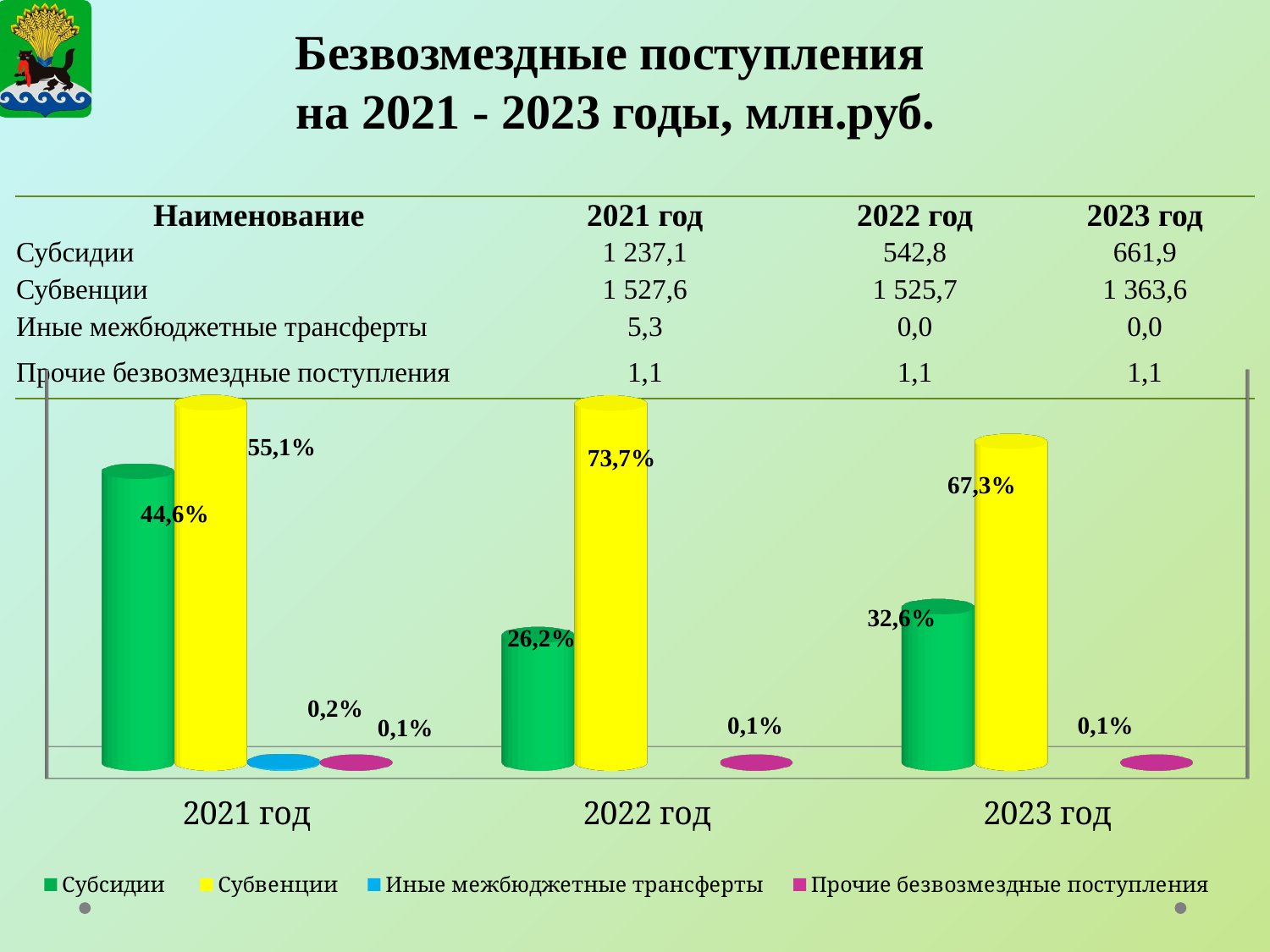
In which year does Субвенции have its highest share on the chart? 2022 год What type of chart is shown on the slide? Bar chart What is the data label for Прочие безвозмездные поступления in 2023 год on the chart? 0,1% What is the data label for Субсидии in 2021 год on the chart? 44,6% How many year categories are shown on the x axis of the chart? 3 What is the data label for Иные межбюджетные трансферты in 2021 год on the chart? 0,2% Which is larger in 2021 год on the chart: Субсидии or Субвенции? Субвенции What is the data label for Субвенции in 2022 год on the chart? 73,7% What is the data label for Субсидии in 2023 год on the chart? 32,6% In which year does Субсидии have its lowest share on the chart? 2022 год How many series does the chart legend list? 4 What is the difference between the Субвенции and Субсидии shares in 2023 год on the chart? 34,7%